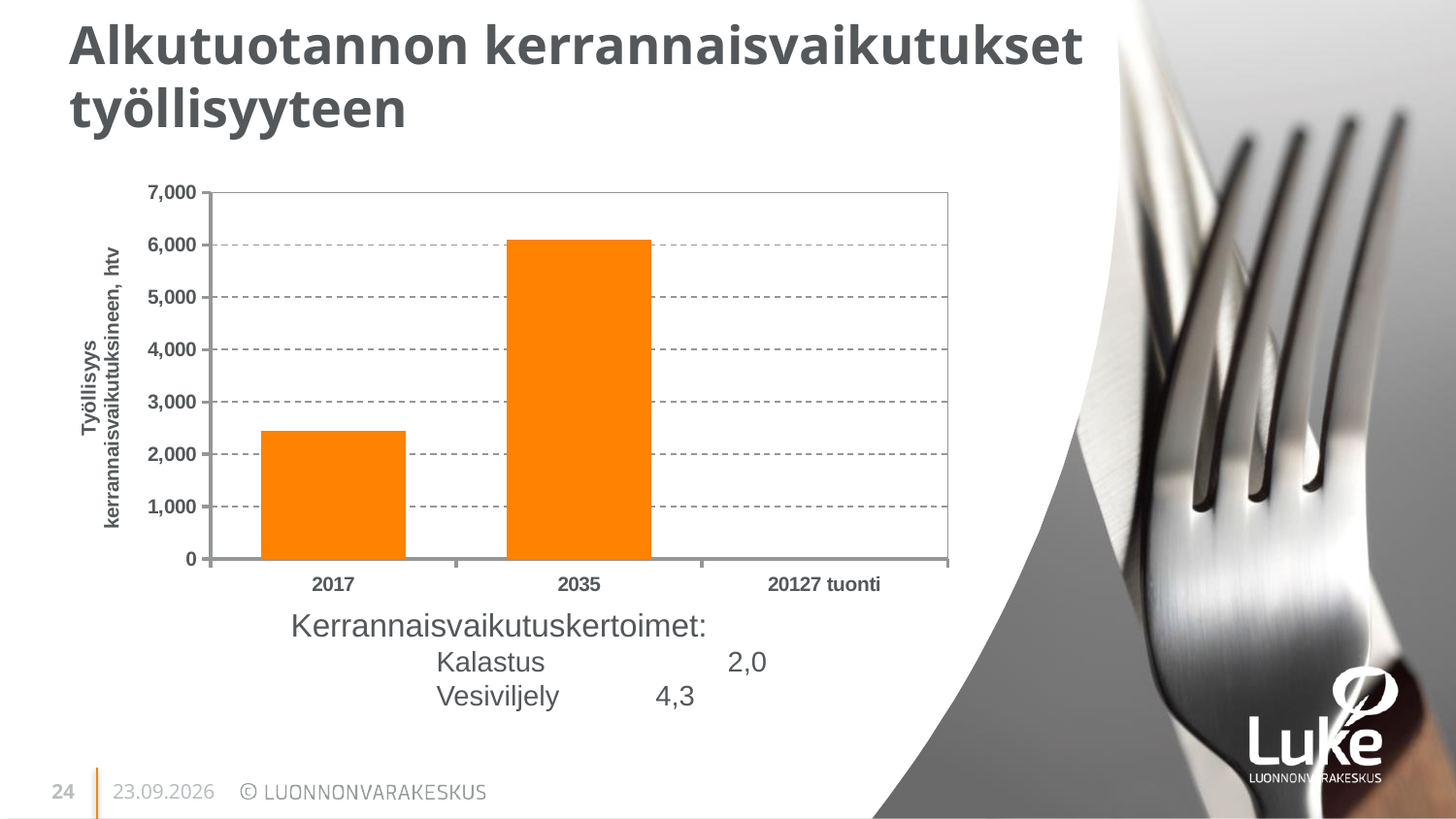
Is the value for 2035 greater or less than 5,000? greater How many bars are plotted in the chart? 2 Is the value for 2017 greater or less than 2,000? greater Which is larger, the value for 2017 or the value for 2035? 2035 What colour are the bars in the chart? orange What is the label of the y axis of the chart? Työllisyys kerrannaisvaikutuksineen, htv Do the bar values rise or fall from 2017 to 2035? rise Is the value for 2035 greater or less than 7,000? less Which category has the tallest bar in the chart? 2035 What kind of chart is shown on the slide? bar chart How many category labels are shown on the x axis of the chart? 3